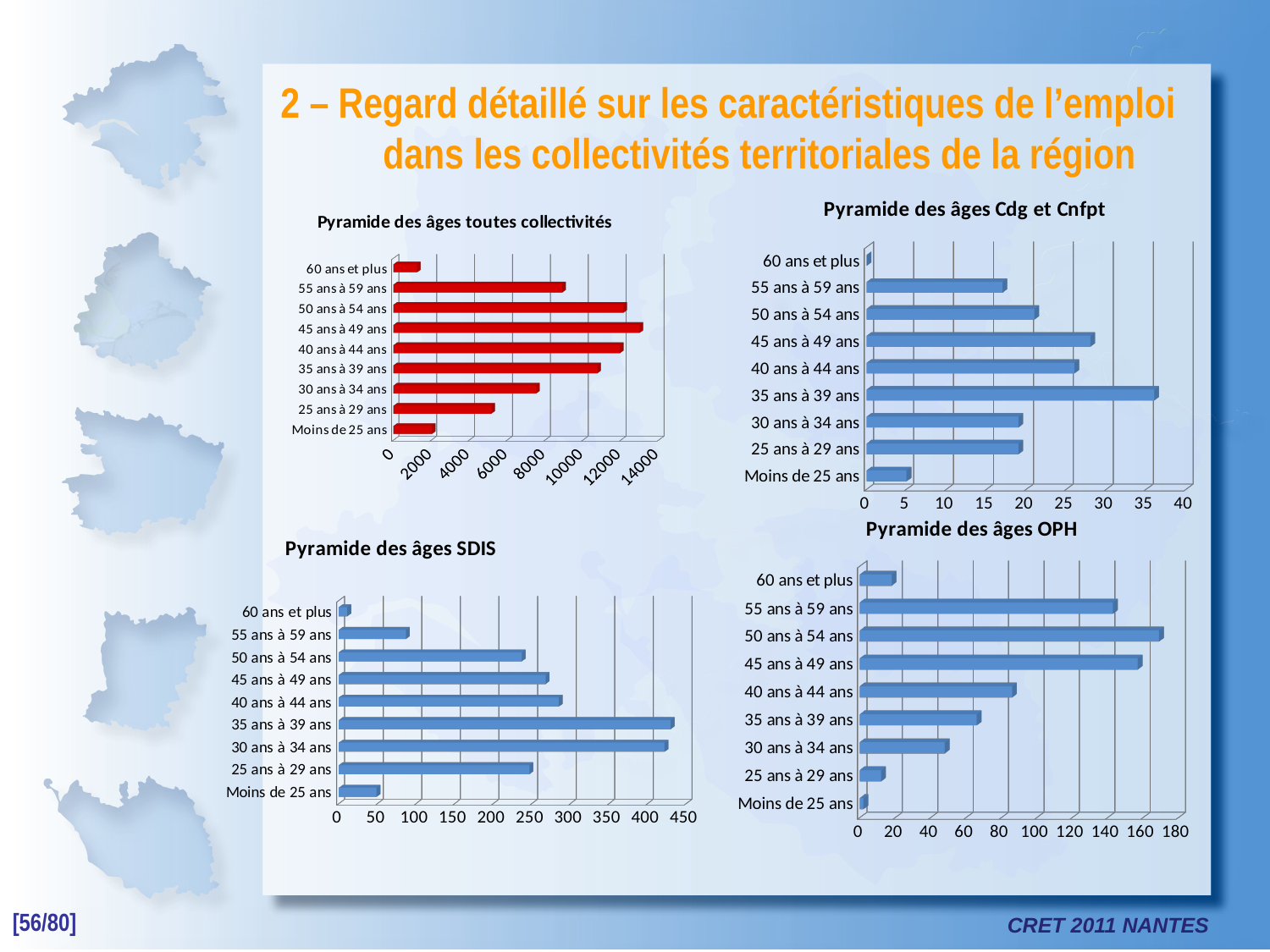
In "Pyramide des âges toutes collectivités", which age category has the highest value? 45 ans à 49 ans In "Pyramide des âges OPH", is the value for 40 ans à 44 ans greater or less than 100? less In "Pyramide des âges OPH", which age category has the highest value? 50 ans à 54 ans In "Pyramide des âges toutes collectivités", which age category has the lowest value? 60 ans et plus In "Pyramide des âges SDIS", which age category has the lowest value? 60 ans et plus In "Pyramide des âges SDIS", is the value for 40 ans à 44 ans greater or less than 250? greater What type of chart is "Pyramide des âges toutes collectivités"? Bar chart In "Pyramide des âges toutes collectivités", how many age categories are plotted? 9 In "Pyramide des âges toutes collectivités", is the value for 55 ans à 59 ans greater or less than 8000? greater How many charts are shown on the slide? 4 In "Pyramide des âges Cdg et Cnfpt", which age category has the highest value? 35 ans à 39 ans